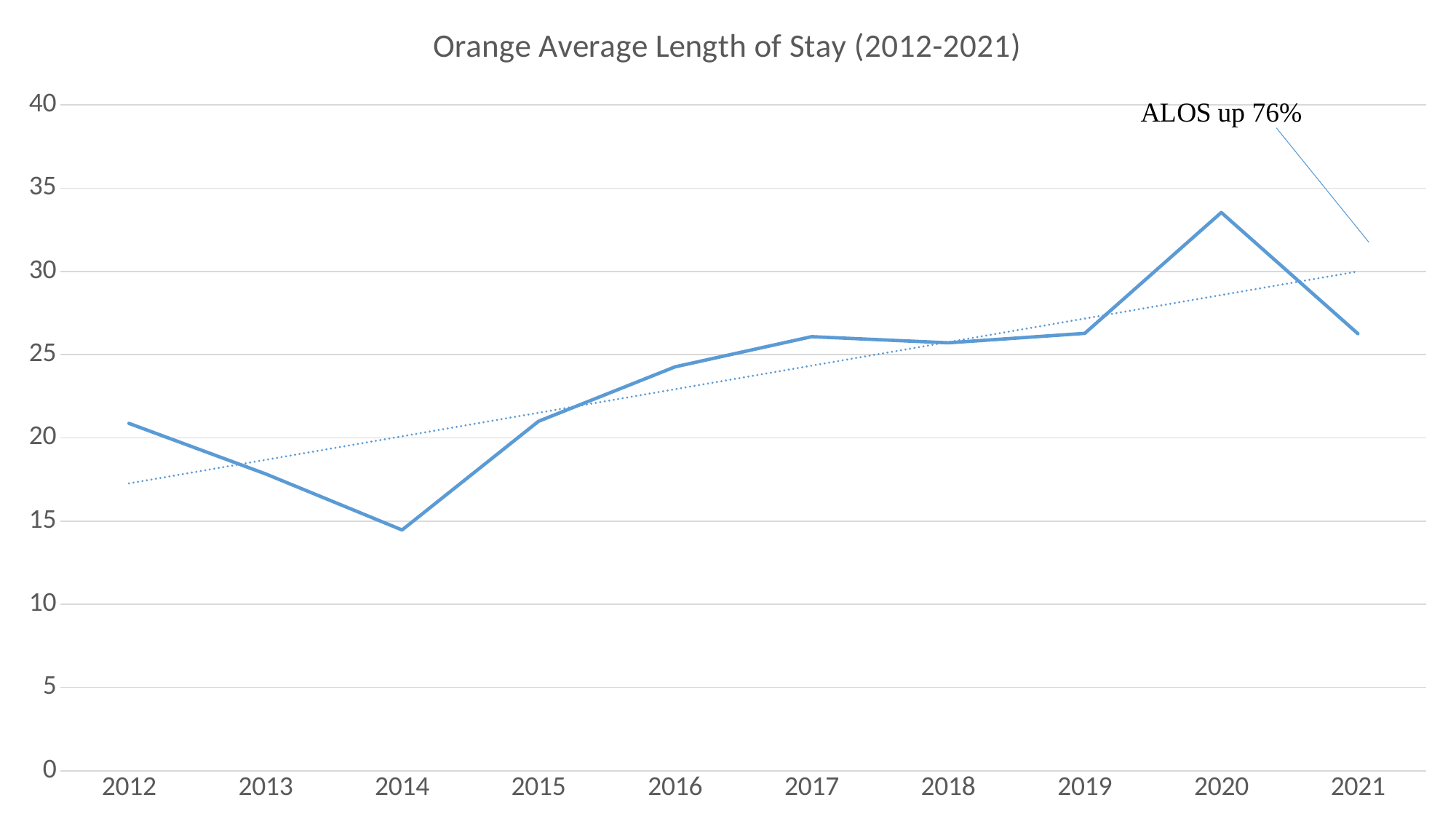
Which year has the highest average length of stay? 2020 Is the value for 2016 greater or less than 25? less Is the value for 2012 greater or less than 20? greater Which year has the larger value, 2020 or 2021? 2020 Which year has the lowest average length of stay? 2014 How many years are plotted along the x axis? 10 What is the title of the chart? Orange Average Length of Stay (2012-2021) What type of chart is shown on the slide? line chart Which year has the larger value, 2014 or 2015? 2015 What does the text annotation on the chart say? ALOS up 76% Is the value for 2020 greater or less than 30? greater